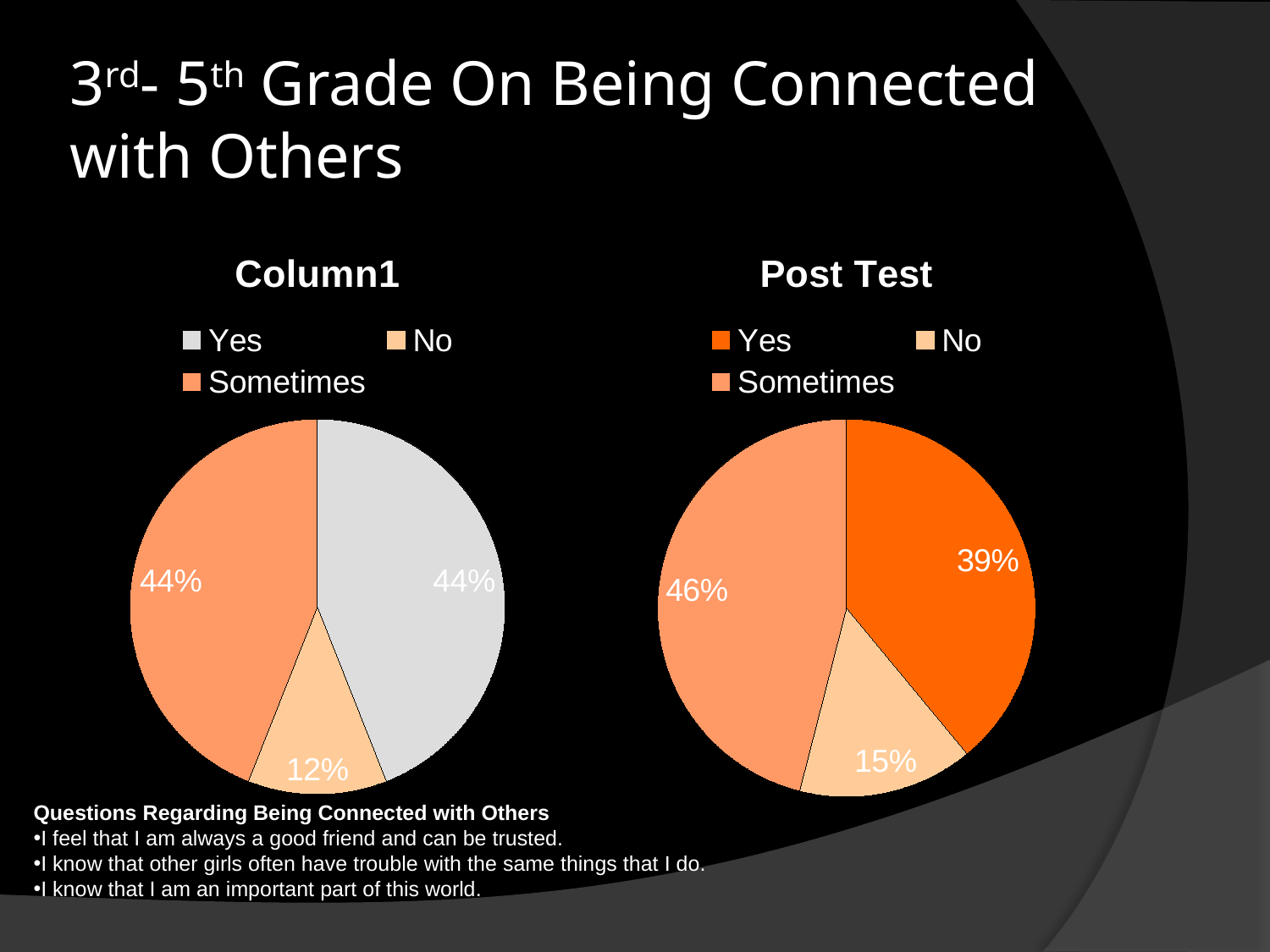
In the Post Test chart, what is the difference between the Sometimes and Yes shares? 7% In the Column1 chart, which is larger, the Yes slice or the No slice? Yes How many categories does the Post Test chart show? 3 In the Column1 chart, what share of responses is Yes? 44% In the Post Test chart, which category has the largest slice? Sometimes What kind of chart is the Column1 chart? Pie chart In the Column1 chart, which category has the smallest slice? No In the Column1 chart, what share of responses is No? 12% In the Post Test chart, what share of responses is Yes? 39% In the Post Test chart, what share of responses is Sometimes? 46% In the Post Test chart, which category has the smallest slice? No What is the title of the chart on the right side of the slide? Post Test